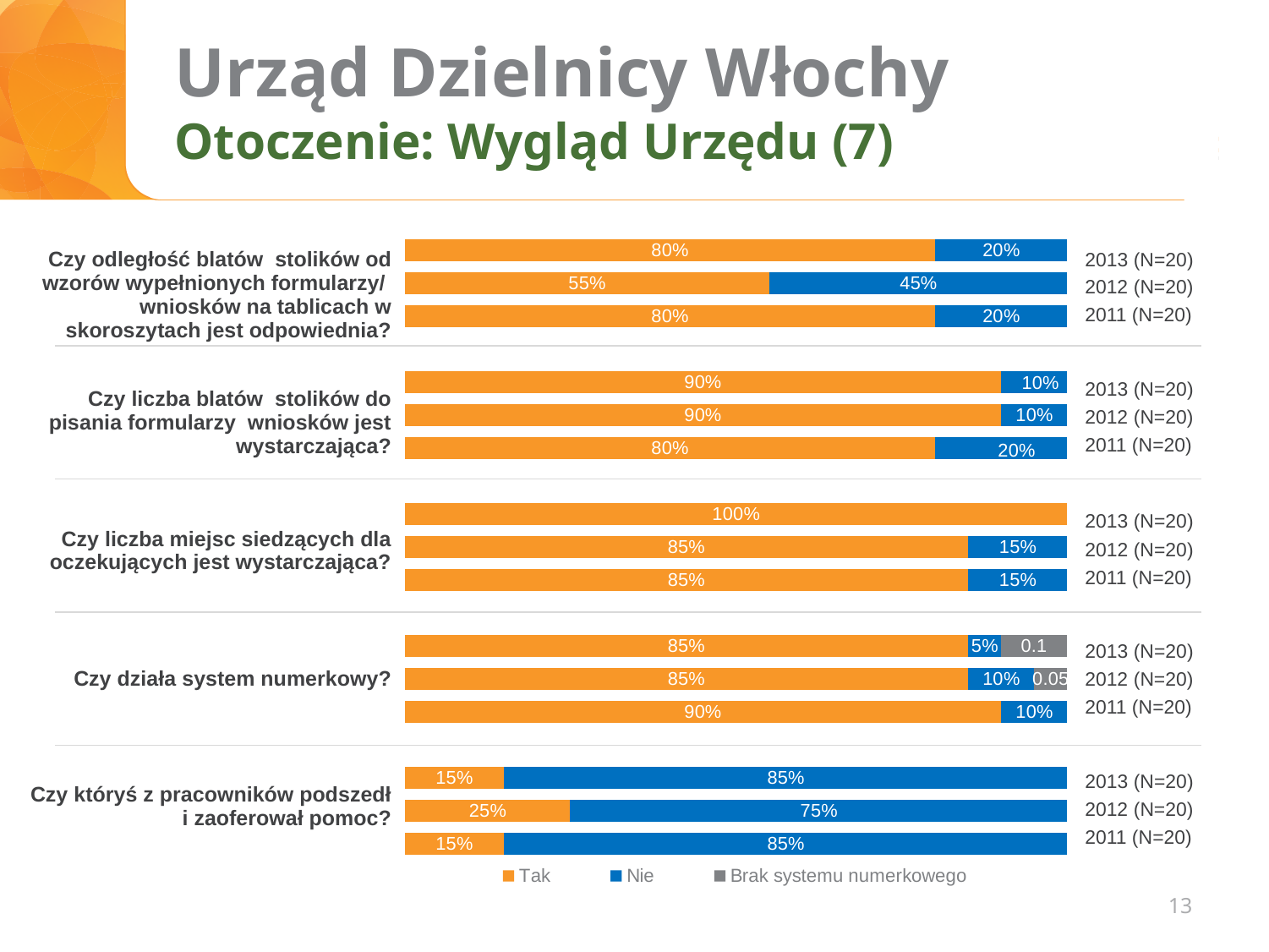
What is the "Tak" value for 2013 for the question "Czy działa system numerkowy?"? 85% What kind of chart is shown on the slide? Stacked bar chart What is the "Nie" value for 2012 for the question "Czy odległość blatów stolików od wzorów wypełnionych formularzy/wniosków na tablicach w skoroszytach jest odpowiednia?"? 45% What is the "Nie" value for 2012 for the question "Czy działa system numerkowy?"? 10% How many years are shown for each question in the chart? 3 How many series does the legend list? 3 For the question "Czy odległość blatów stolików od wzorów wypełnionych formularzy/wniosków na tablicach w skoroszytach jest odpowiednia?", which year has the lowest "Tak" value? 2012 What is the "Tak" value for 2013 for the question "Czy liczba miejsc siedzących dla oczekujących jest wystarczająca?"? 100% Which legend entry is shown in gray? Brak systemu numerkowego For the question "Czy któryś z pracowników podszedł i zaoferował pomoc?", which year has the larger "Tak" value, 2012 or 2013? 2012 For the question "Czy liczba blatów stolików do pisania formularzy wniosków jest wystarczająca?", what is the difference between the "Tak" value for 2013 and for 2011? 10 percentage points What is the "Nie" value for 2012 for the question "Czy któryś z pracowników podszedł i zaoferował pomoc?"? 75%